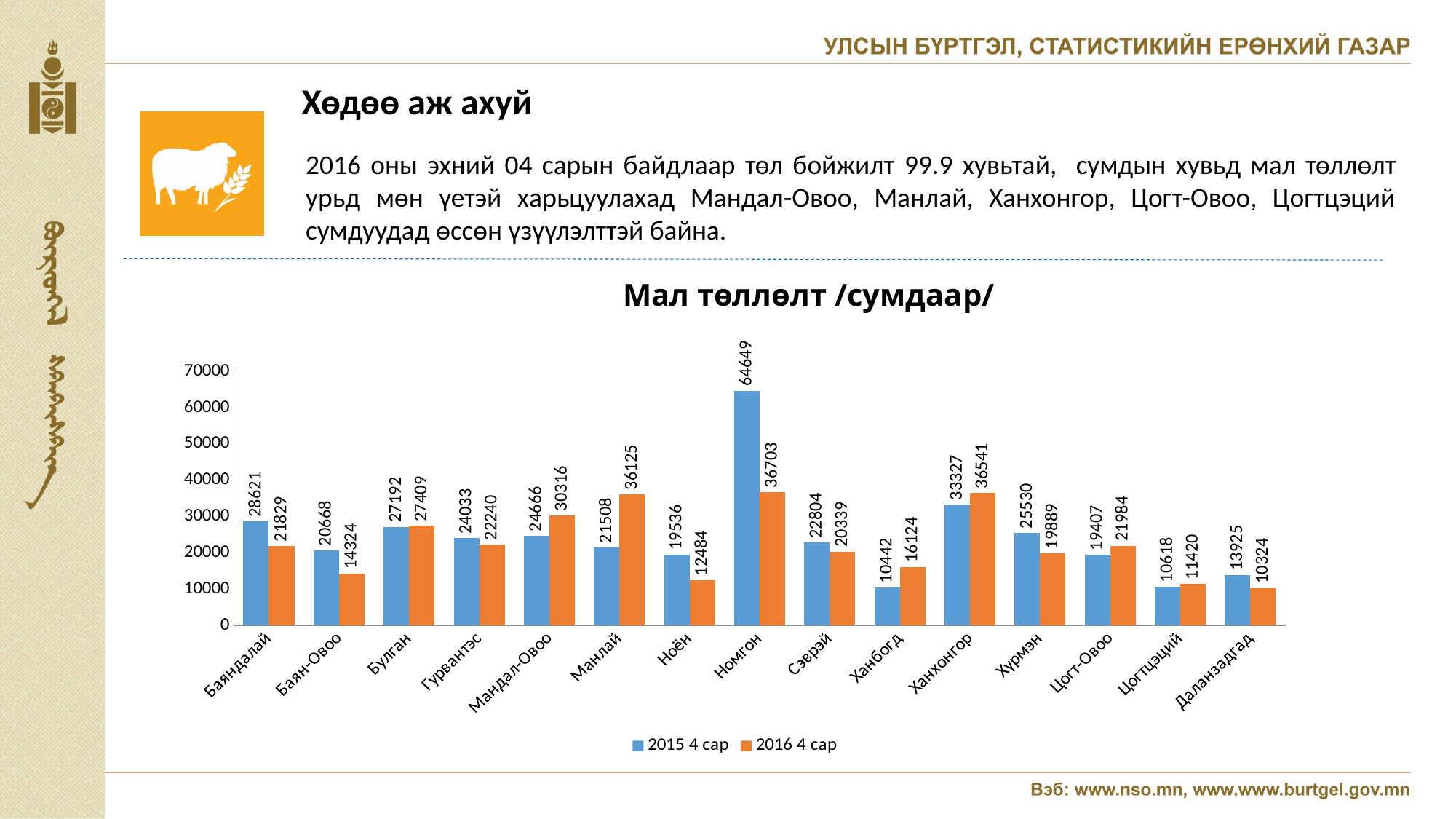
What is the value for Цогтцэций in the 2015 4 сар series? 10618 What is the difference between the 2015 4 сар and 2016 4 сар values for Номгон? 27946 What is the title of the chart? Мал төллөлт /сумдаар/ Is the 2016 4 сар value for Ханхонгор greater or less than 30000? greater How many series does the legend list? 2 What is the value for Номгон in the 2015 4 сар series? 64649 For Ханбогд, which is larger: the 2015 4 сар value or the 2016 4 сар value? 2016 4 сар Which sum has the highest value in the 2015 4 сар series? Номгон What is the value for Манлай in the 2016 4 сар series? 36125 What type of chart is shown on the slide? bar chart How many sums (categories) are shown on the x axis? 15 Which sum has the lowest value in the 2016 4 сар series? Даланзадгад